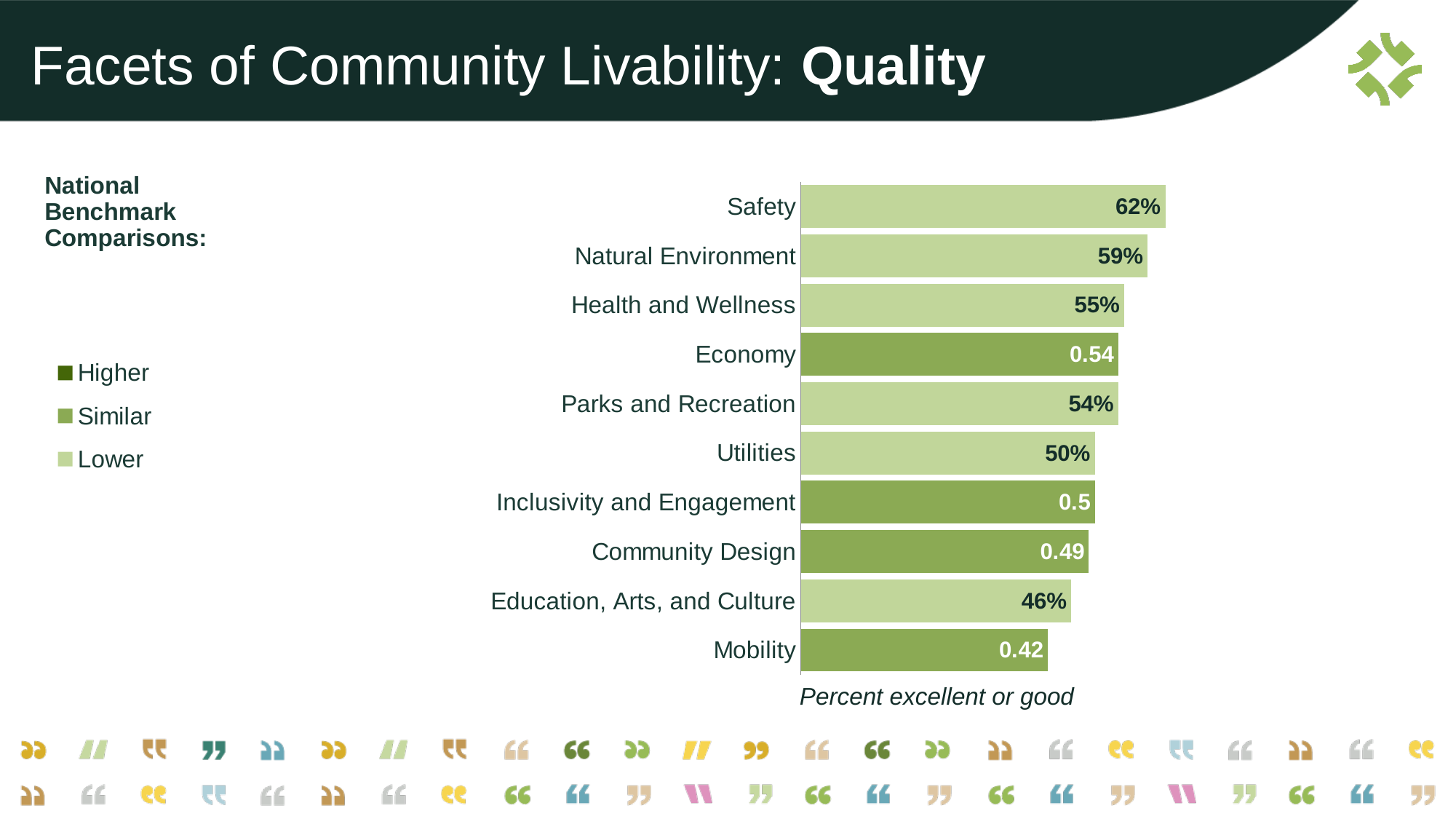
Which facet has the highest value? Safety What is the value for Safety? 62% Which is larger, the value for Health and Wellness or the value for Utilities? Health and Wellness What is the difference between the values for Safety and Natural Environment? 3% What value is shown for Mobility? 0.42 What is the value for Education, Arts, and Culture? 46% What kind of chart is shown on the slide? Bar chart How many facets are shown in the chart? 10 What value is shown for Economy? 0.54 How many entries does the legend list? 3 Which facet has the lowest value? Mobility What is the value for Natural Environment? 59%